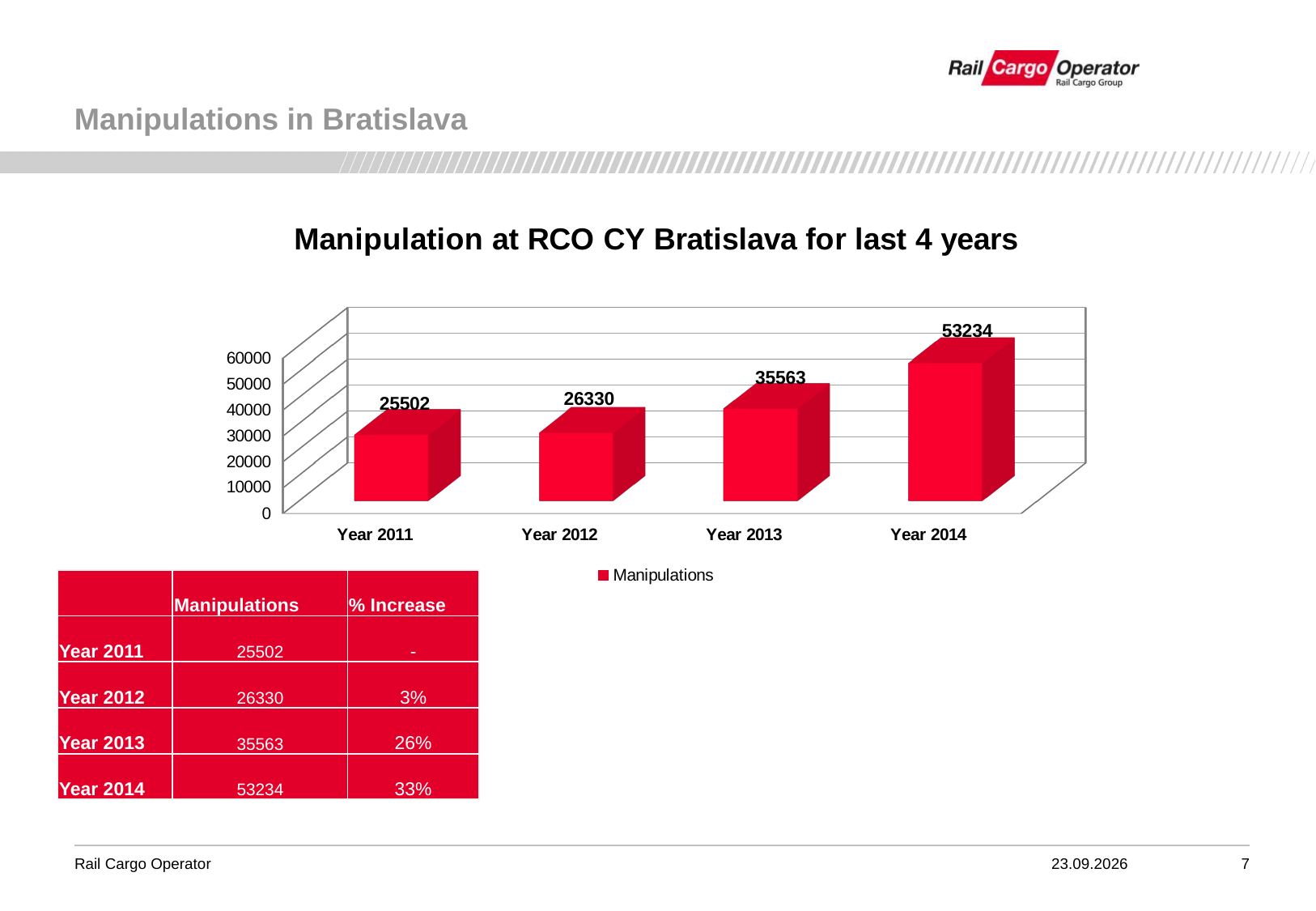
Which year has the lowest number of manipulations? Year 2011 What is the value for Year 2011? 25502 What kind of chart is shown? bar chart What is the difference between the values for Year 2014 and Year 2013? 17671 Do the values rise or fall from Year 2011 to Year 2014? rise Which year has the highest number of manipulations? Year 2014 What is the value for Year 2014? 53234 What is the difference between the values for Year 2012 and Year 2011? 828 Which is larger, the value for Year 2013 or the value for Year 2012? Year 2013 What is the value for Year 2013? 35563 How many years are shown on the x axis? 4 Is the value for Year 2014 greater or less than 50000? greater